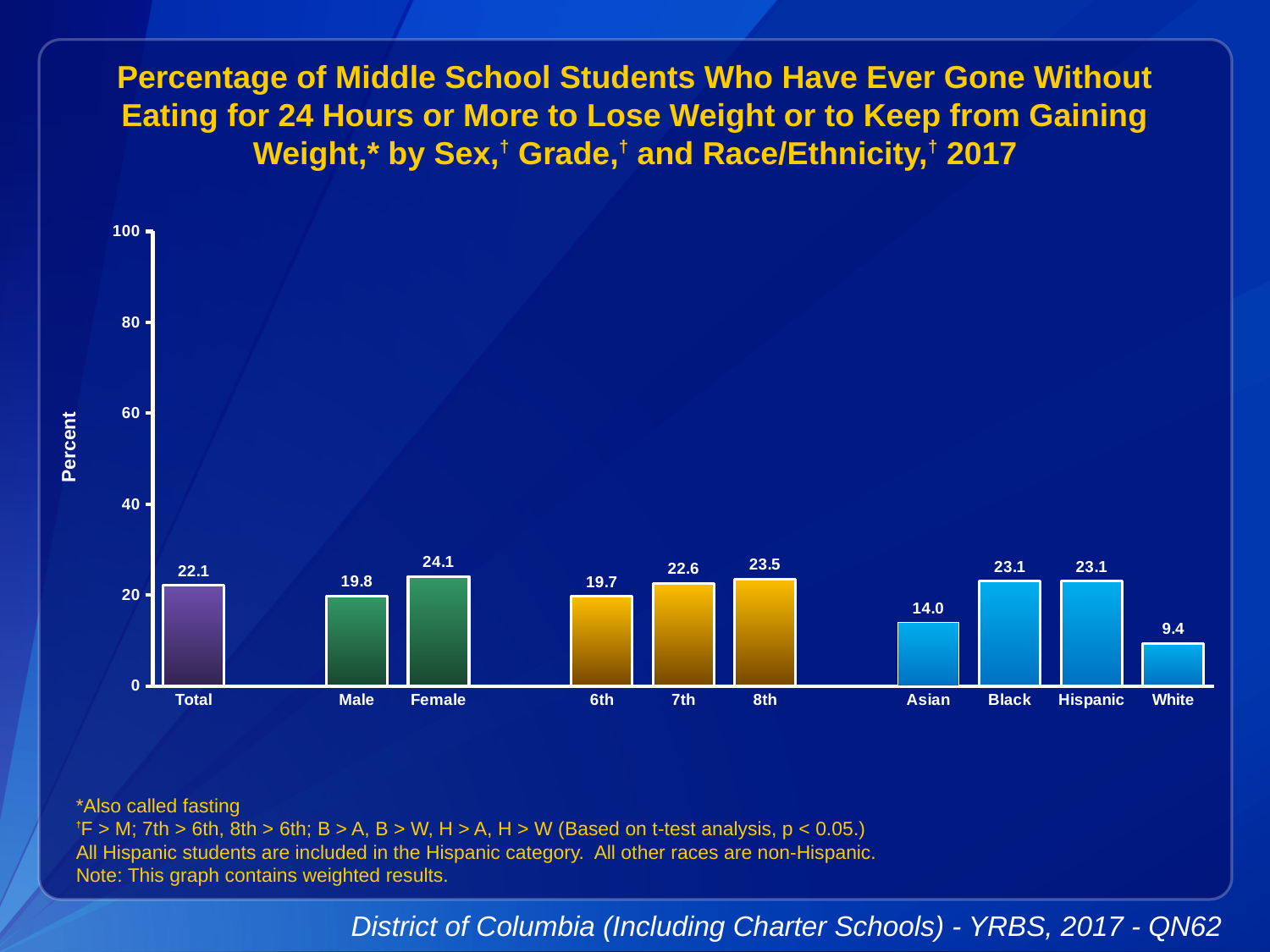
What is the value for Total? 22.1 What is the difference between the Female and Male values? 4.3 Which is larger, the value for 8th or the value for 6th? 8th Which category has the lowest value? White What is the value for Female? 24.1 Do the values rise or fall from 6th to 7th grade? rise Which category has the highest value? Female What is the difference between the Black and White values? 13.7 How many categories are shown on the x axis? 10 What is the value for Asian? 14.0 What kind of chart is this? bar chart Is the value for Hispanic greater or less than 20? greater